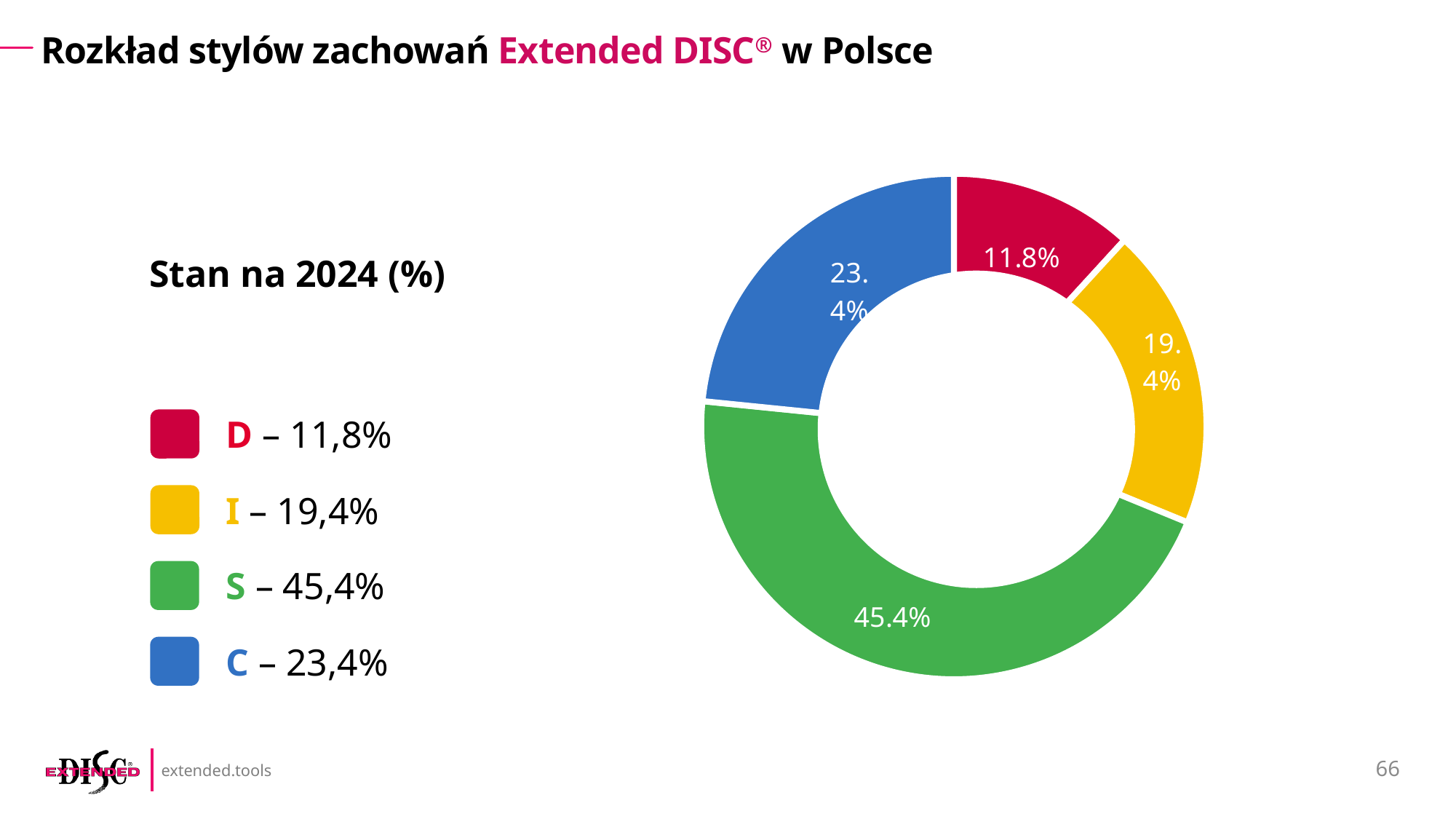
Which is larger, the share for C or the share for I? C How many slices does the chart have? 4 What colour is the slice for S? Green What is the value shown for the I slice? 19.4% What is the difference between the S share and the C share? 22.0 percentage points What is the value shown for the D slice? 11.8% Which style has the largest share of the chart? S Which style has the smallest share of the chart? D What is the value shown for the S slice? 45.4% What is the value shown for the C slice? 23.4% What kind of chart is shown on the slide? Doughnut (pie) chart What is the heading shown next to the legend on the slide? Stan na 2024 (%)